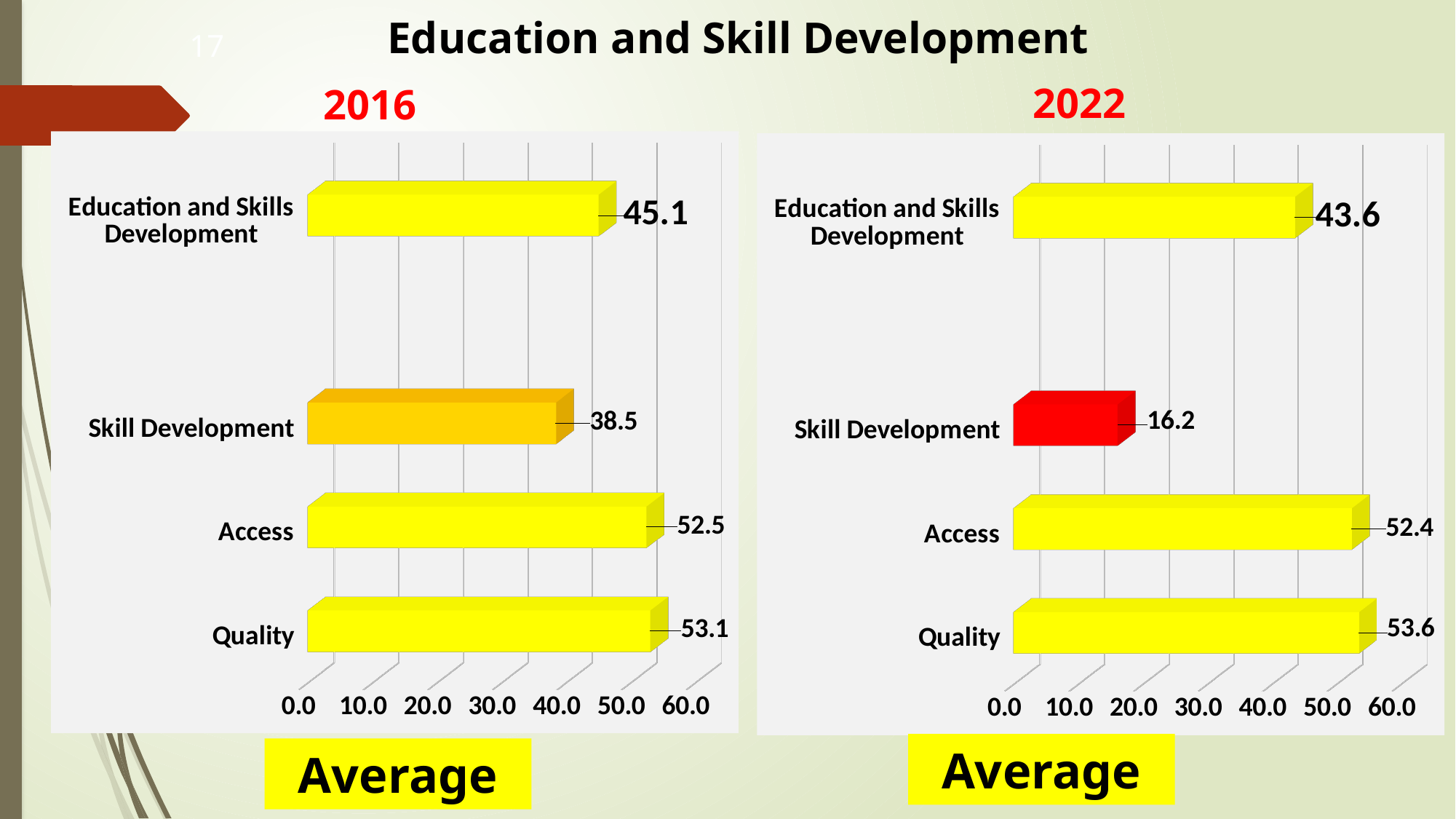
In the 2016 chart, what is the value for Skill Development? 38.5 In the 2016 chart, what is the difference between Quality and Access? 0.6 In the 2022 chart, which category has the highest value? Quality In the 2016 chart, what is the value for Education and Skills Development? 45.1 What is the difference between the Skill Development values in the 2016 chart and the 2022 chart? 22.3 In the 2016 chart, which category has the lowest value? Skill Development In the 2022 chart, which category has the lowest value? Skill Development What type of chart is the 2022 chart? Bar chart In the 2022 chart, what is the value for Skill Development? 16.2 In the 2022 chart, is the value for Access greater or less than 50.0? greater In the 2022 chart, what is the value for Quality? 53.6 How many categories are shown in the 2016 chart? 4